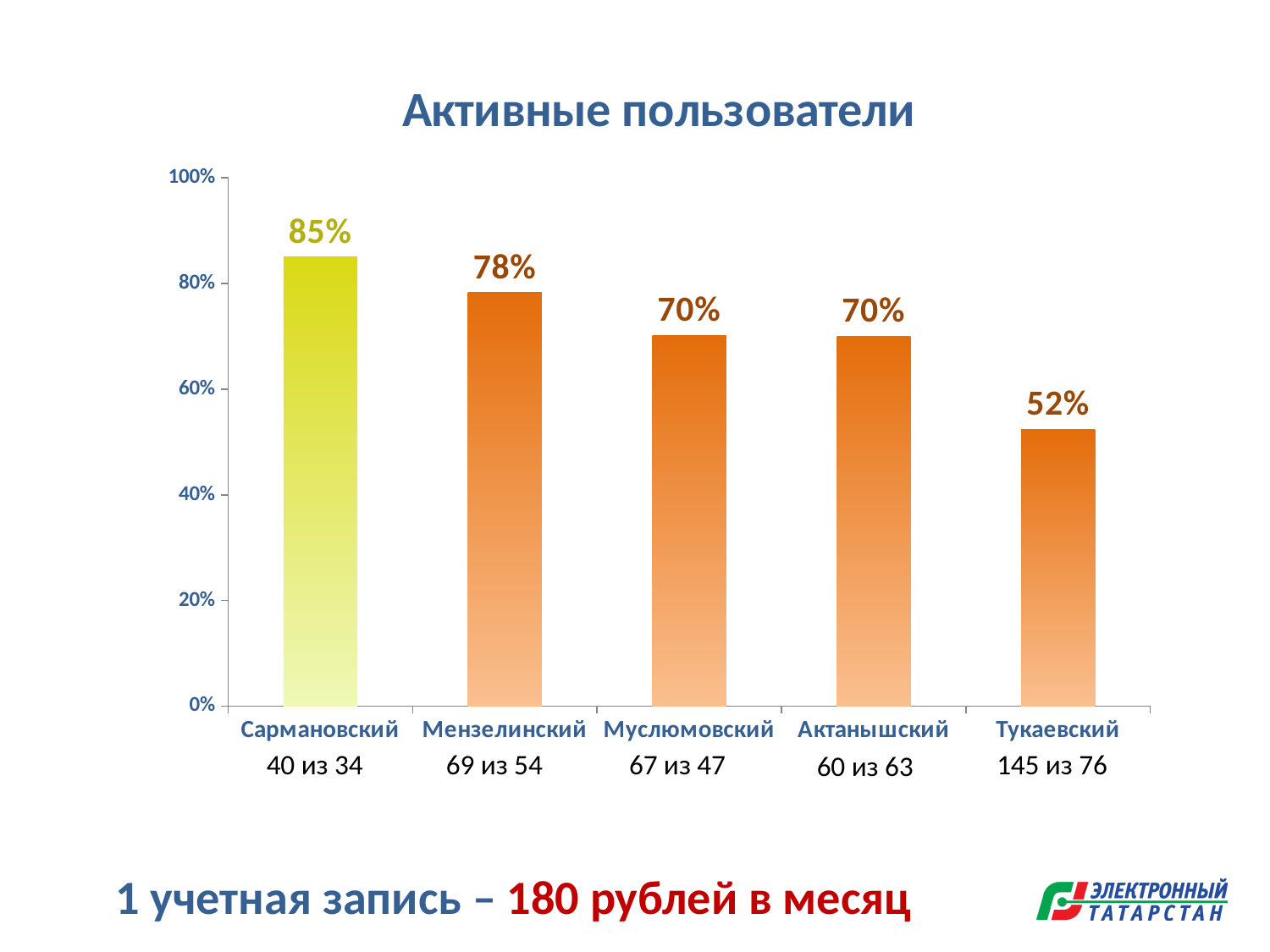
How many categories are shown in the chart? 5 Is the value for Тукаевский greater or less than 60%? less Which category has the lowest value? Тукаевский What is the difference between the values for Сармановский and Тукаевский? 33% What is the value for Сармановский? 85% Which category has the highest value? Сармановский What is the title of the chart? Активные пользователи What kind of chart is this? bar chart What is the difference between the values for Мензелинский and Муслюмовский? 8% What is the value for Мензелинский? 78% Which is larger, the value for Мензелинский or the value for Актанышский? Мензелинский What is the value for Тукаевский? 52%